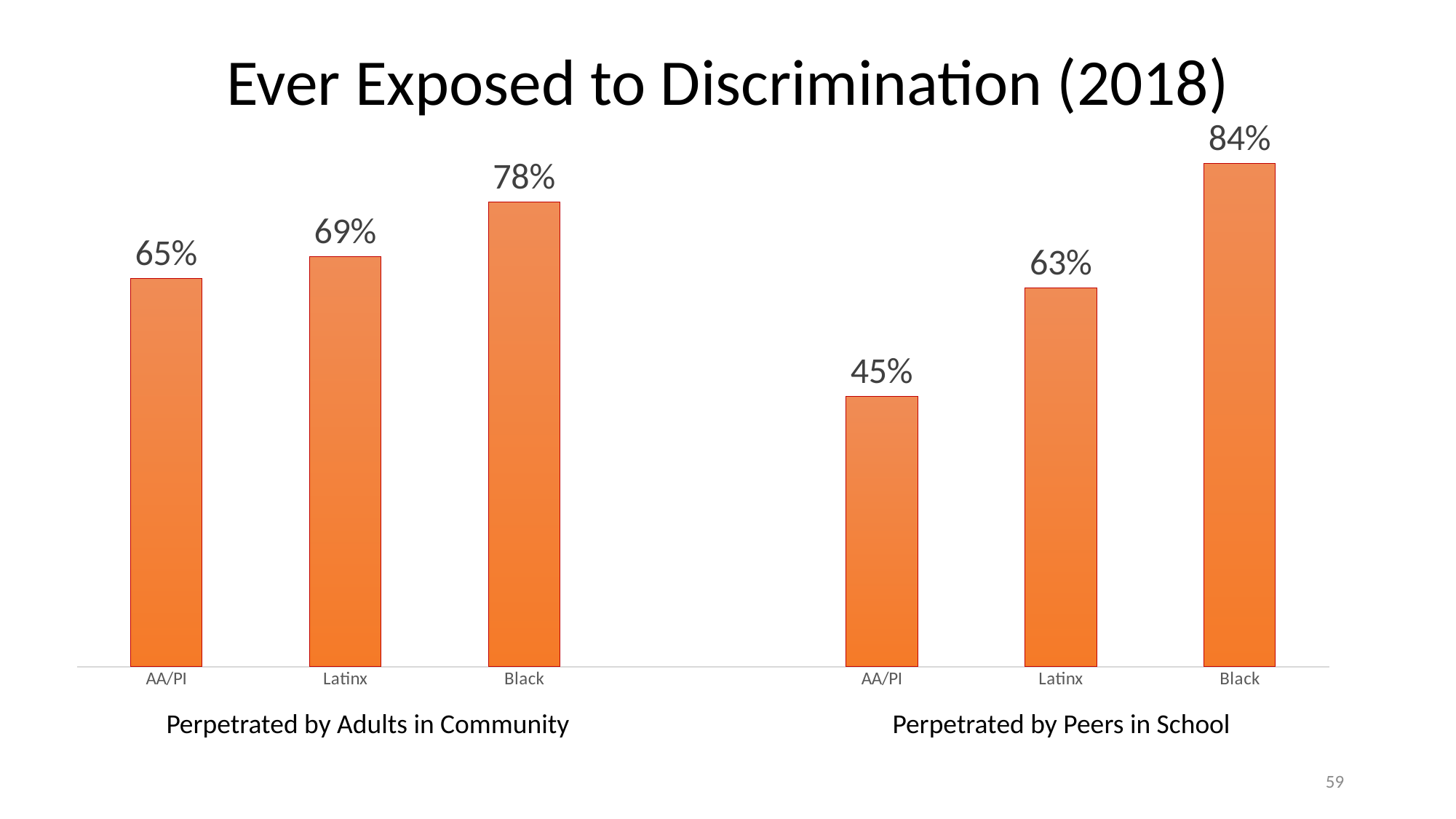
In the 'Perpetrated by Adults in Community' chart, what is the value for Latinx? 69% In the 'Perpetrated by Adults in Community' chart, what is the difference between the values for Black and Latinx? 9% In the 'Perpetrated by Peers in School' chart, which category has the highest value? Black In the 'Perpetrated by Adults in Community' chart, what is the value for Black? 78% What kind of chart is the 'Perpetrated by Adults in Community' chart? Bar chart In the 'Perpetrated by Adults in Community' chart, which category has the lowest value? AA/PI How many categories are shown in the 'Perpetrated by Peers in School' chart? 3 What is the title of the slide? Ever Exposed to Discrimination (2018) In the 'Perpetrated by Peers in School' chart, what is the value for AA/PI? 45% Which is larger: the value for Latinx in the 'Perpetrated by Adults in Community' chart or the value for Latinx in the 'Perpetrated by Peers in School' chart? Perpetrated by Adults in Community In the 'Perpetrated by Peers in School' chart, what is the difference between the values for Black and AA/PI? 39% In the 'Perpetrated by Peers in School' chart, do the values rise or fall from AA/PI to Black? Rise